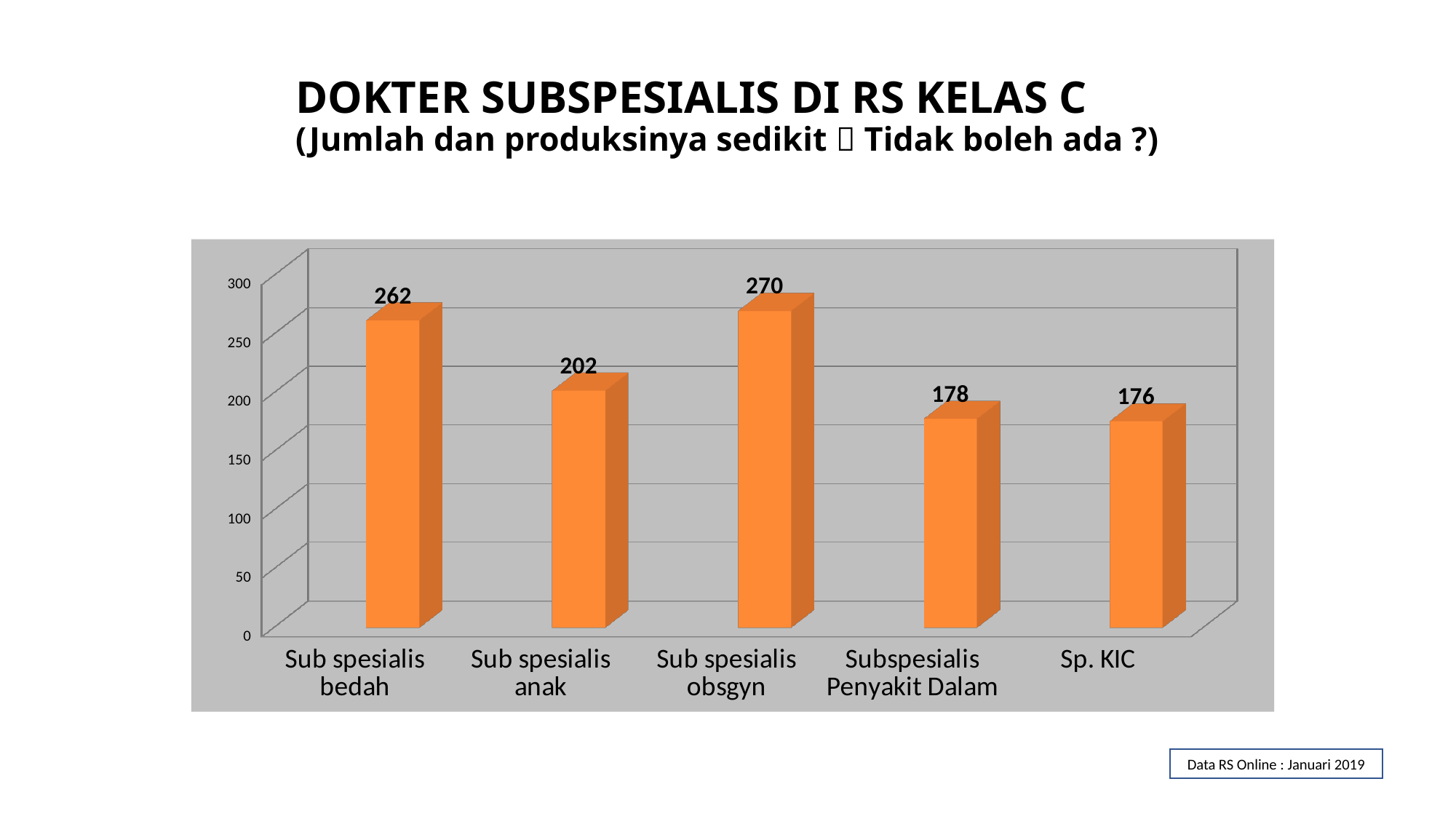
What is the value for Sub spesialis bedah? 262 Which category has the highest value? Sub spesialis obsgyn Which is larger, the value for Sub spesialis bedah or the value for Sub spesialis anak? Sub spesialis bedah What is the value for Sub spesialis anak? 202 What is the difference between the values for Sub spesialis obsgyn and Sub spesialis bedah? 8 What kind of chart is shown on the slide? Bar chart Which category has the lowest value? Sp. KIC What is the value for Sp. KIC? 176 What is the value for Subspesialis Penyakit Dalam? 178 What is the difference between the values for Sub spesialis anak and Subspesialis Penyakit Dalam? 24 What is the value for Sub spesialis obsgyn? 270 How many categories are shown in the chart? 5